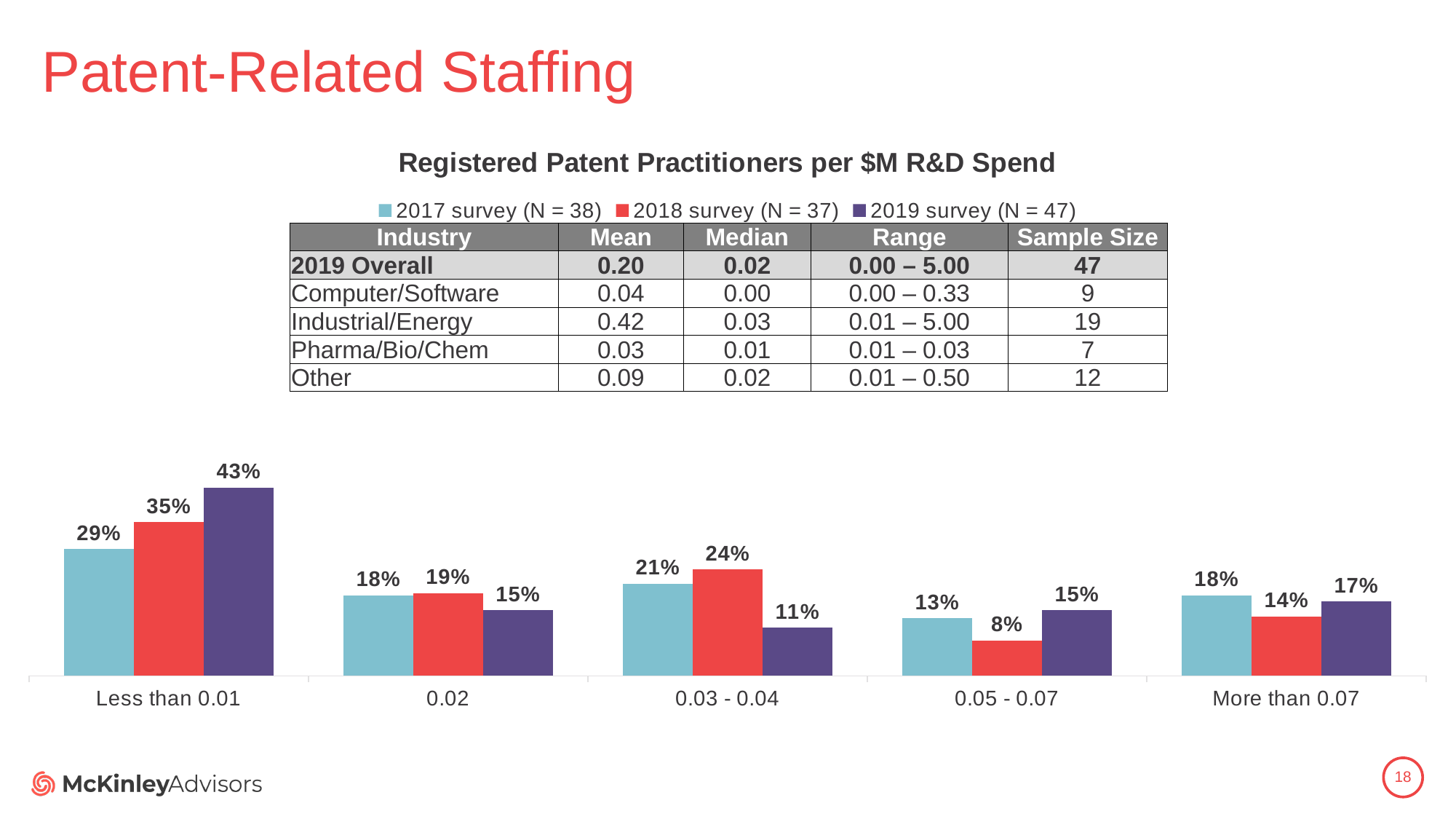
What kind of chart is shown on the slide? Bar chart How many series does the chart legend list? 3 Which is larger in the '0.03 - 0.04' category: the 2018 survey value or the 2019 survey value? 2018 survey How many categories are shown on the x axis of the chart? 5 What is the value for the 2018 survey in the '0.05 - 0.07' category? 8% What is the title of the chart? Registered Patent Practitioners per $M R&D Spend Which category has the lowest value for the 2018 survey? 0.05 - 0.07 Which category has the highest value for the 2019 survey? Less than 0.01 What is the difference between the 2019 survey and 2017 survey values in the 'Less than 0.01' category? 14% What is the sample size (N) for the 2019 survey shown in the legend? 47 What is the value for the 2019 survey in the 'Less than 0.01' category? 43% What is the value for the 2017 survey in the '0.03 - 0.04' category? 21%